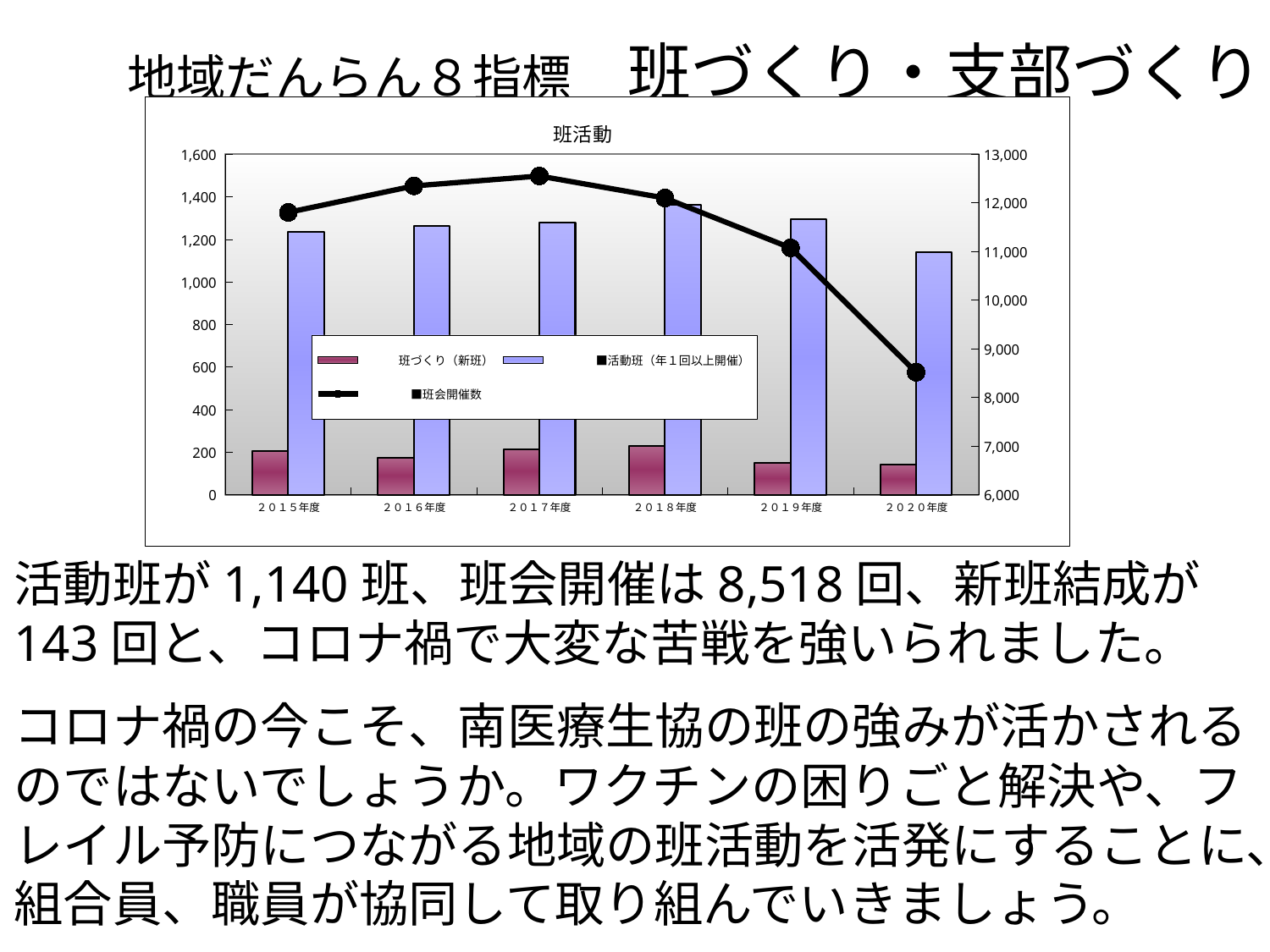
In which year is the 活動班（年１回以上開催） bar the tallest? 2018年度 Is the 活動班（年１回以上開催） value for 2018年度 greater or less than 1,200? greater What kind of chart is shown on the slide? Combined bar and line chart How many series does the chart legend list? 3 Is the 班会開催数 value for 2020年度 greater or less than 9,000? less In which year is the 班会開催数 line at its lowest? 2020年度 In which year is the 活動班（年１回以上開催） bar the shortest? 2020年度 What is the title of the chart? 班活動 In which year is the 班会開催数 line at its highest? 2017年度 Does the 班会開催数 line rise or fall from 2017年度 to 2020年度? Fall How many fiscal years are shown on the x axis of the chart? 6 Is the 班づくり（新班） value for 2019年度 greater or less than 200? less